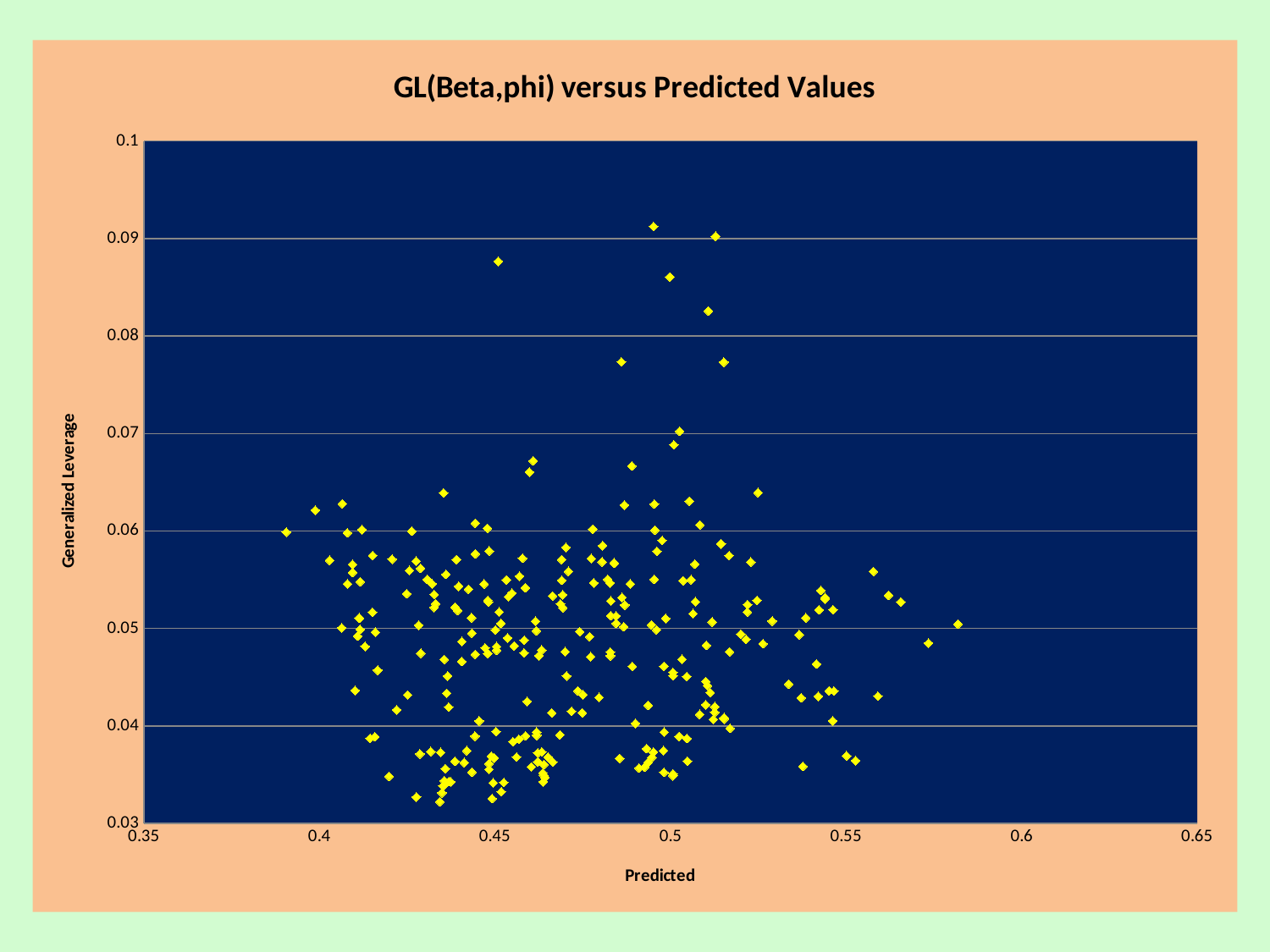
What is the label of the vertical axis? Generalized Leverage What is the maximum value shown on the vertical axis? 0.1 What kind of chart is shown on the slide? Scatter plot What is the title of the chart? GL(Beta,phi) versus Predicted Values Are any points plotted with a Generalized Leverage greater than 0.1? No Is the highest Generalized Leverage value plotted greater or less than 0.08? greater Is the lowest Generalized Leverage value plotted greater or less than 0.04? less